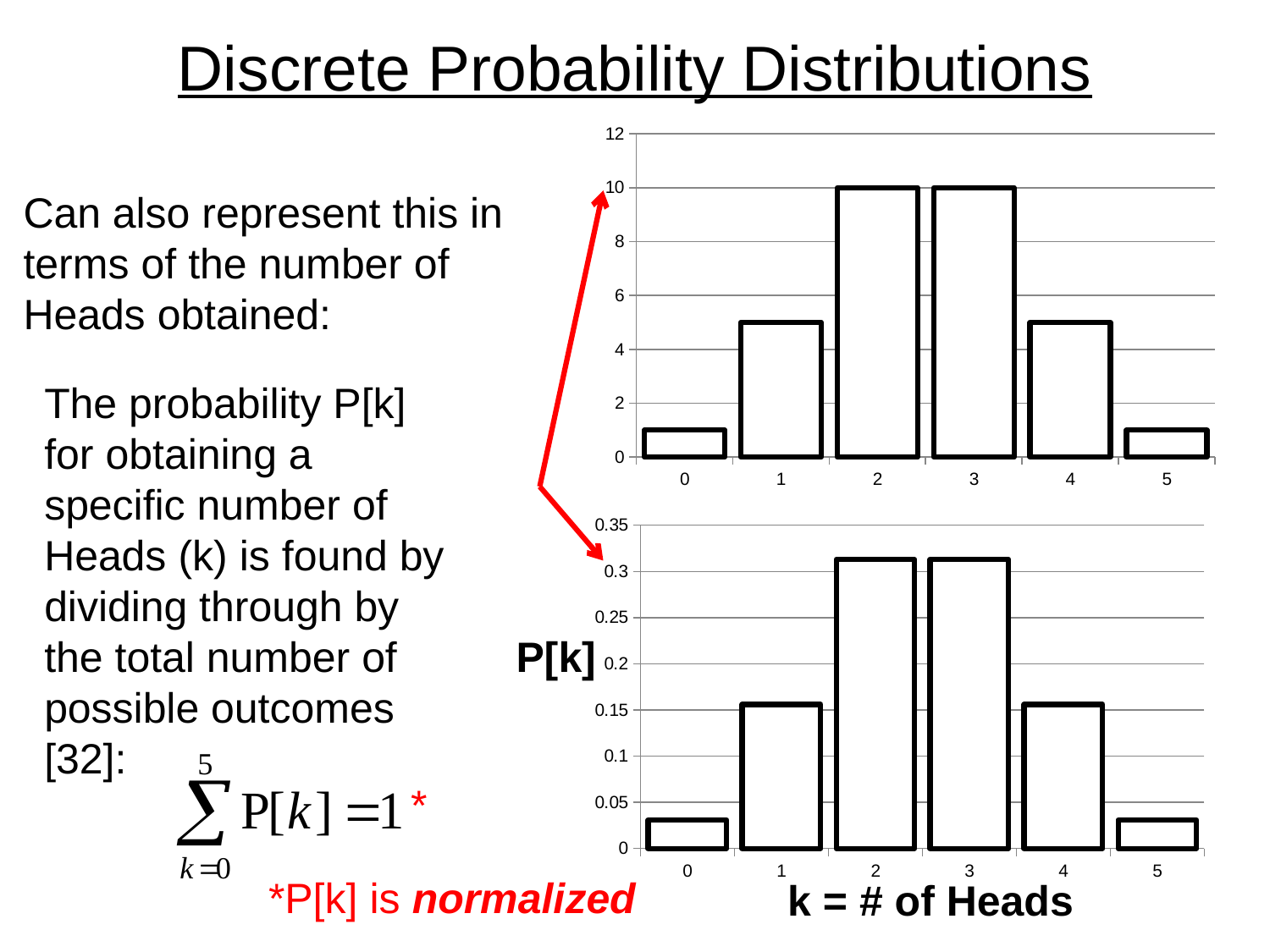
How many categories are shown on the x axis of the bottom chart? 6 In the top chart, is the value for k = 0 greater or less than 2? less In the top chart, what is the value for k = 2? 10 In the bottom chart, is the value for k = 2 greater or less than 0.3? greater In the bottom chart, which is larger, the value for k = 0 or the value for k = 1? k = 1 What is the x-axis label of the bottom chart? k = # of Heads In the bottom chart, is the value for k = 5 greater or less than 0.05? less In the top chart, which is larger, the value for k = 1 or the value for k = 5? k = 1 In the top chart, what is the value for k = 3? 10 What kind of chart is the top chart? bar chart